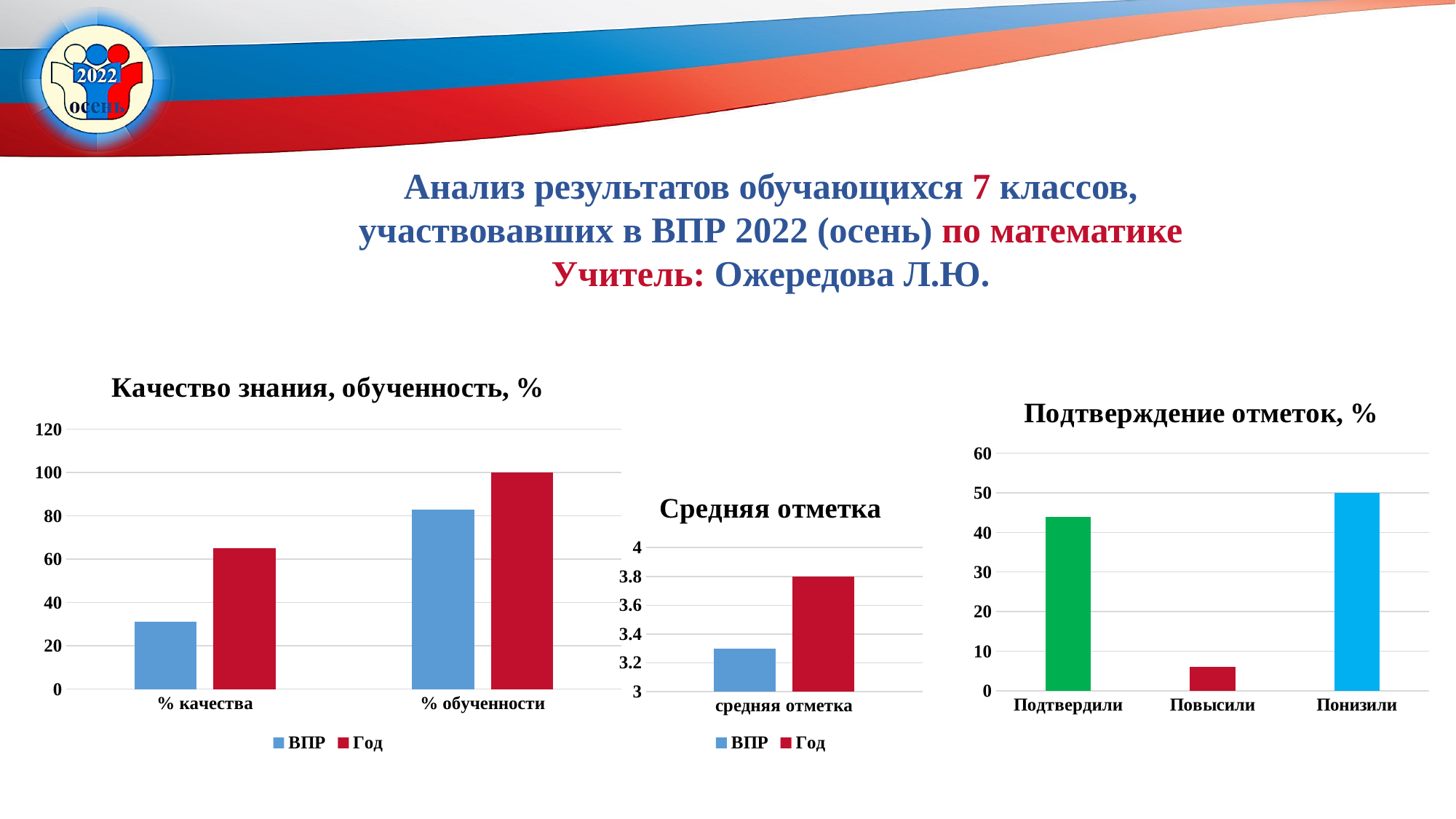
In the chart titled 'Подтверждение отметок, %', which category has the lowest value? Повысили In the chart titled 'Подтверждение отметок, %', is the value for 'Подтвердили' greater or less than 40? greater In the chart titled 'Подтверждение отметок, %', what is the value for 'Понизили'? 50 In the chart titled 'Качество знания, обученность, %', is the 'ВПР' value for '% обученности' greater or less than 80? greater In the chart titled 'Качество знания, обученность, %', which series has the larger value for '% качества', 'ВПР' or 'Год'? Год How many series does the legend of the chart titled 'Качество знания, обученность, %' list? 2 In the chart titled 'Качество знания, обученность, %', what is the value of the 'Год' series for '% обученности'? 100 In the chart titled 'Средняя отметка', which series has the larger value, 'ВПР' or 'Год'? Год In the chart titled 'Средняя отметка', is the 'ВПР' value greater or less than 3.4? less What kind of chart is the chart titled 'Подтверждение отметок, %'? bar chart In the chart titled 'Средняя отметка', what is the value of the 'Год' series? 3.8